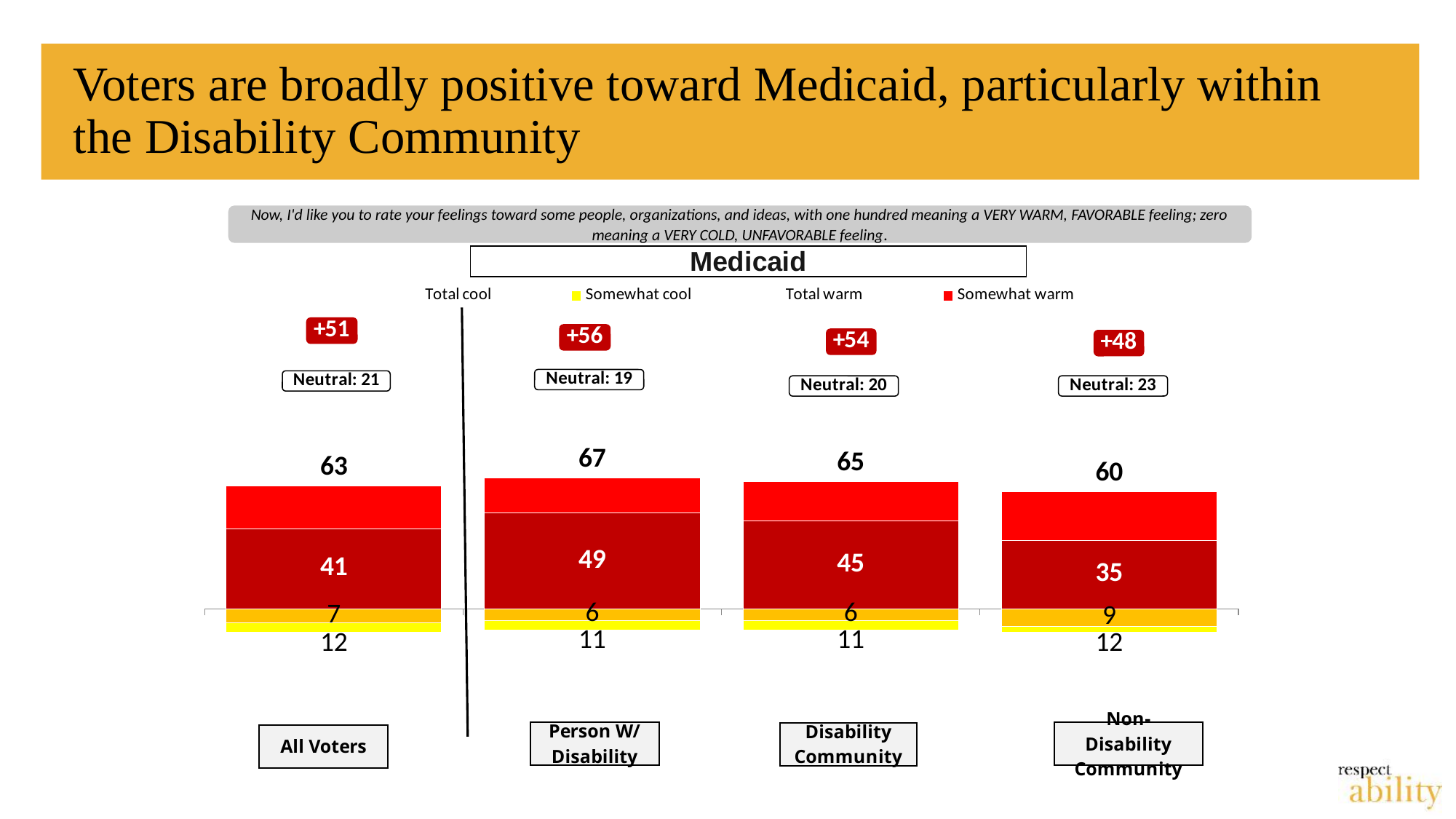
Which category has the highest Total warm value? Person W/ Disability What is the Total warm value for Person W/ Disability? 67 Which category has the lowest Total warm value? Non-Disability Community How many categories are shown on the x axis of the chart? 4 What is the difference between the Total warm values for Person W/ Disability and Non-Disability Community? 7 How many series does the legend list? 4 What is the Total warm value for All Voters? 63 What is the Total cool value for Non-Disability Community? 12 Which is larger, the Total warm value for Disability Community or for All Voters? Disability Community What kind of chart is shown on the slide? Stacked bar chart What net score is shown above the Non-Disability Community bar? +48